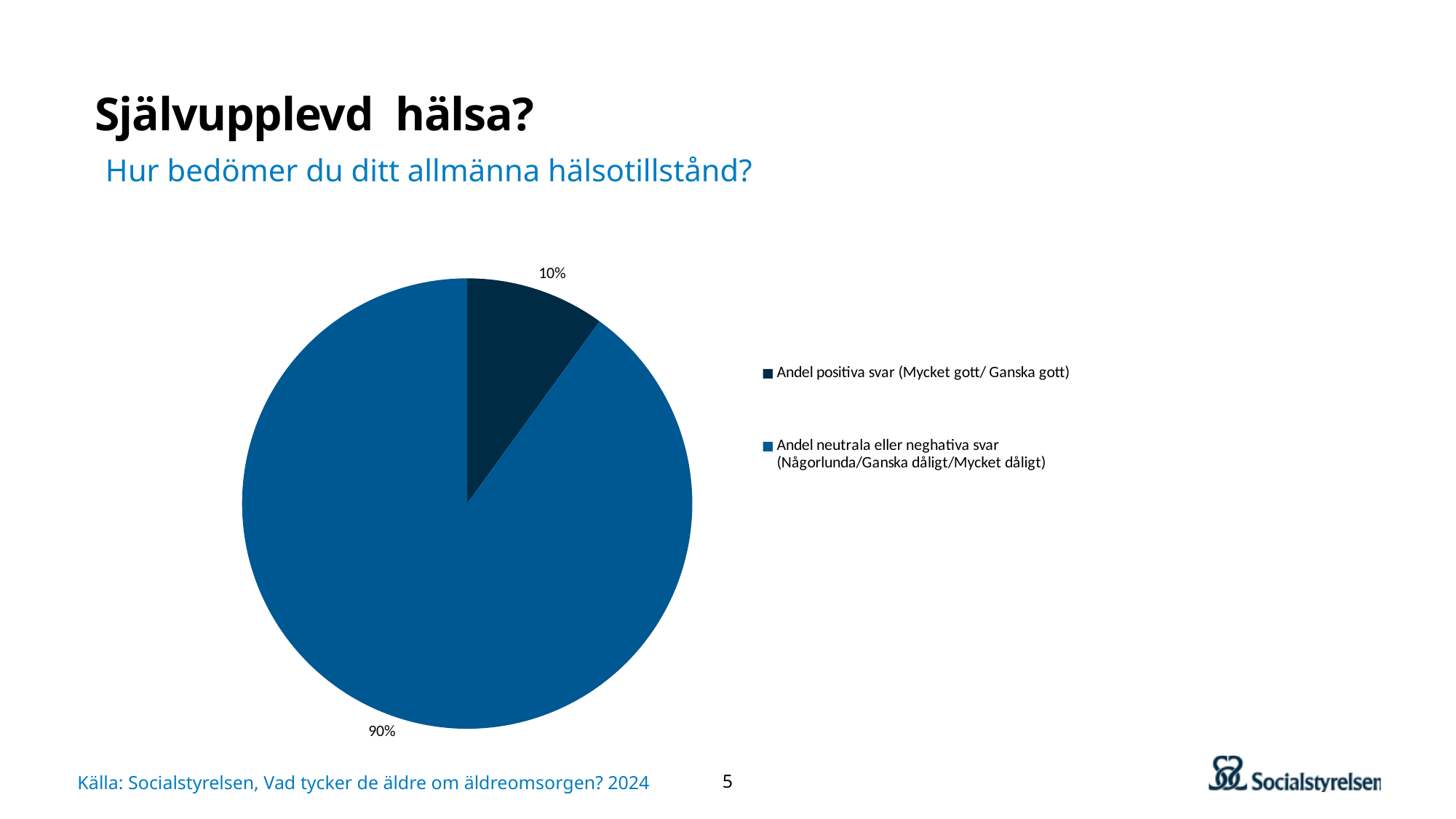
What share of the pie is labelled for 'Andel neutrala eller neghativa svar (Någorlunda/Ganska dåligt/Mycket dåligt)'? 90% Which category has the largest slice of the pie? Andel neutrala eller neghativa svar (Någorlunda/Ganska dåligt/Mycket dåligt) How many entries does the legend list? 2 What share of the pie is labelled for 'Andel positiva svar (Mycket gott/ Ganska gott)'? 10% Which category has the smallest slice of the pie? Andel positiva svar (Mycket gott/ Ganska gott) What question is shown as the subtitle above the pie chart? Hur bedömer du ditt allmänna hälsotillstånd? Which slice is larger: 'Andel positiva svar' or 'Andel neutrala eller neghativa svar'? Andel neutrala eller neghativa svar How many slices does the pie chart have? 2 Which legend entry is shown in the darker navy colour? Andel positiva svar (Mycket gott/ Ganska gott) What is the total of the two percentages shown on the pie chart? 100% What kind of chart is shown on the slide? Pie chart What is the difference in percentage points between the two slices of the pie? 80